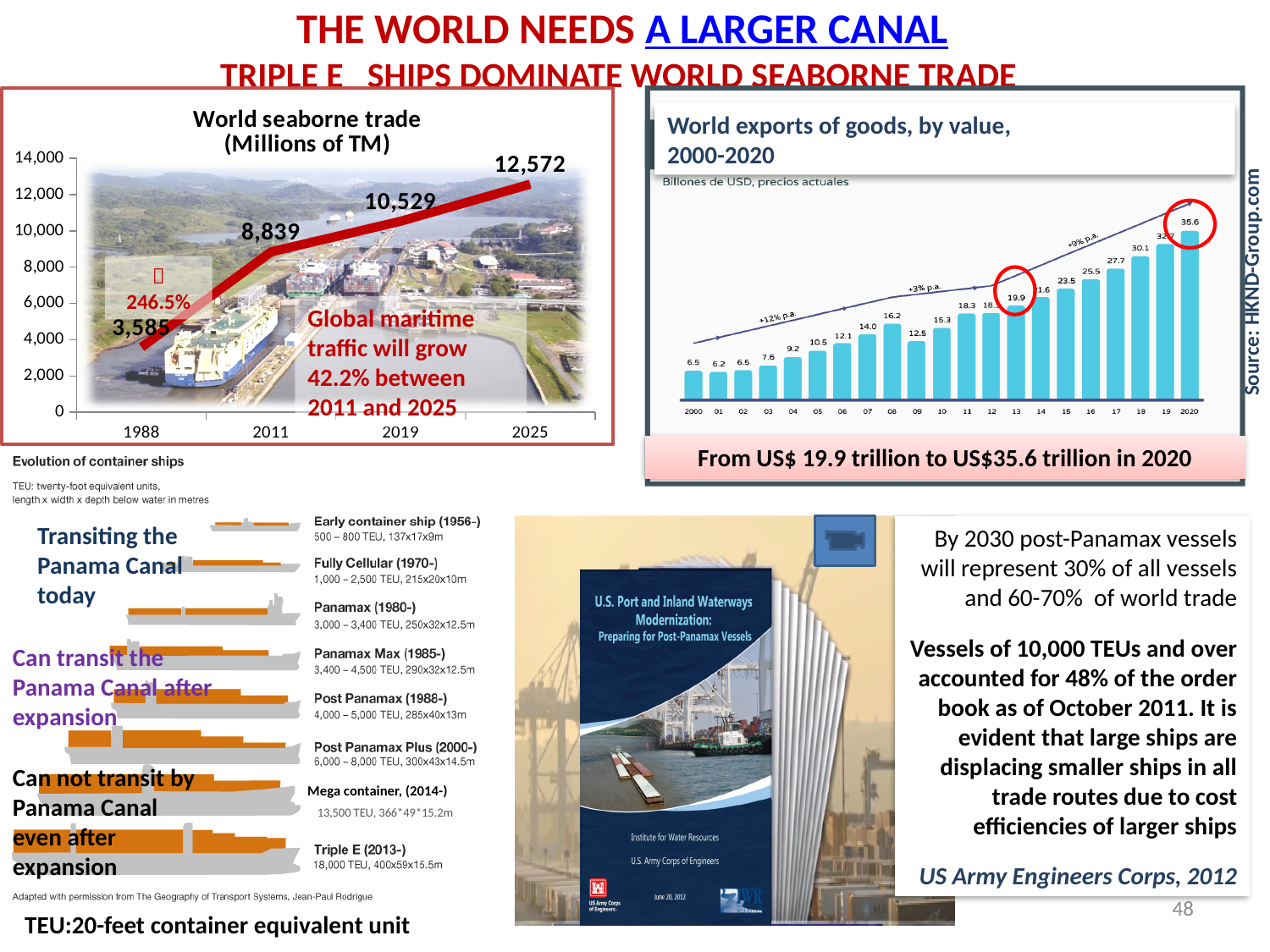
In the 'World exports of goods, by value, 2000-2020' chart, what is the value for 2020? 35.6 In the 'World exports of goods, by value, 2000-2020' chart, which is larger, the value for 2008 or the value for 2009? 2008 In the 'World seaborne trade (Millions of TM)' chart, what is the difference between the 2019 and 2011 values? 1,690 In the 'World seaborne trade (Millions of TM)' chart, which year has the highest value? 2025 In the 'World seaborne trade (Millions of TM)' chart, do the values rise or fall from 1988 to 2025? rise In the 'World seaborne trade (Millions of TM)' chart, how many years are plotted on the x axis? 4 In the 'World exports of goods, by value, 2000-2020' chart, what is the value for 2013? 19.9 In the 'World exports of goods, by value, 2000-2020' chart, which year has the lowest value? 2001 What kind of chart is 'World seaborne trade (Millions of TM)'? line chart In the 'World seaborne trade (Millions of TM)' chart, what is the value for 2011? 8,839 In the 'World seaborne trade (Millions of TM)' chart, what is the value for 2025? 12,572 In the 'World seaborne trade (Millions of TM)' chart, what is the value for 1988? 3,585